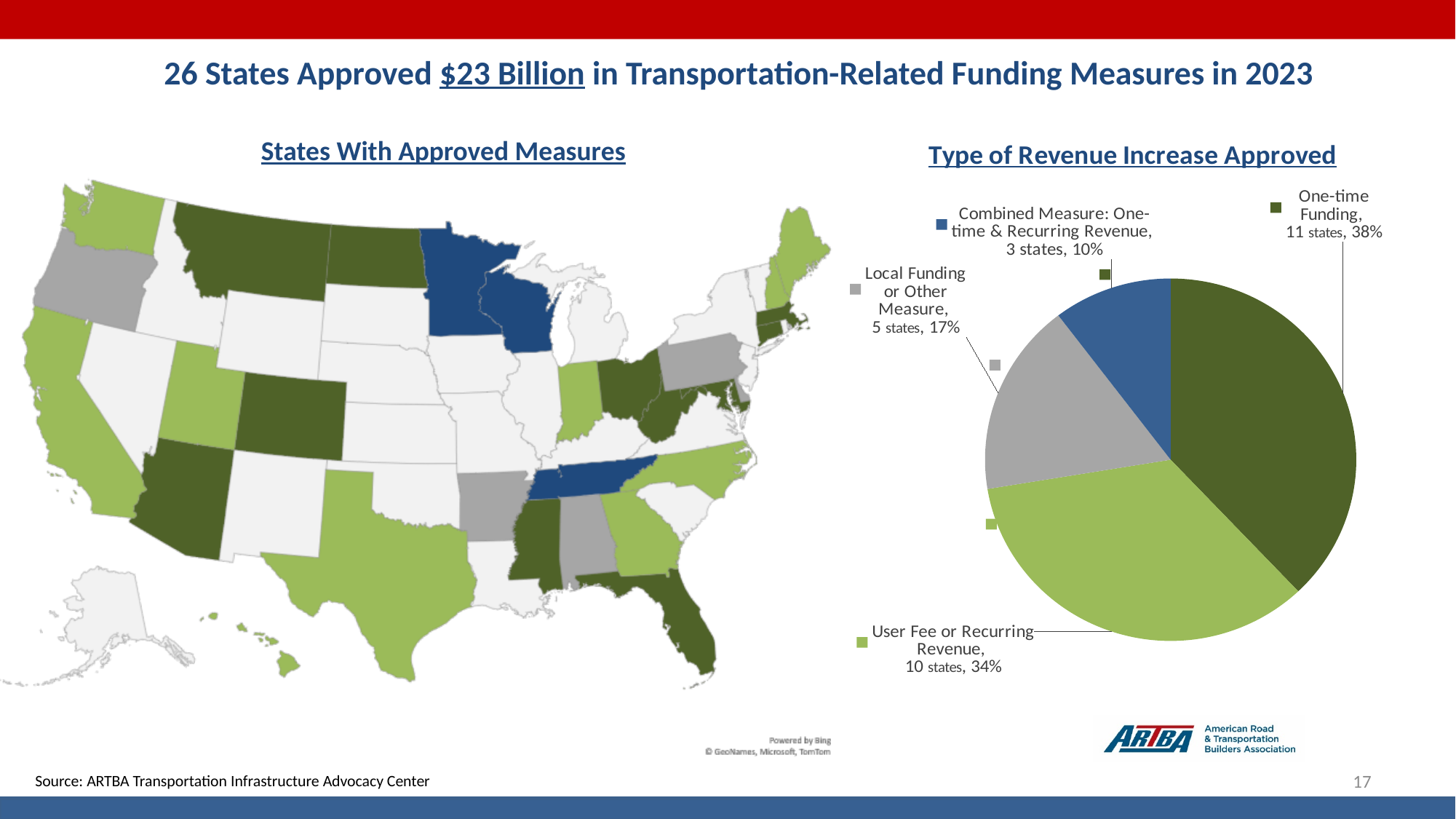
In the 'Type of Revenue Increase Approved' chart, what is the difference in percentage between One-time Funding and User Fee or Recurring Revenue? 4% In the 'Type of Revenue Increase Approved' chart, how many states approved One-time Funding? 11 states In the 'Type of Revenue Increase Approved' chart, how many states approved a Combined Measure: One-time & Recurring Revenue? 3 states In the 'Type of Revenue Increase Approved' chart, which category has the smallest share? Combined Measure: One-time & Recurring Revenue In the 'Type of Revenue Increase Approved' chart, which has a larger share: User Fee or Recurring Revenue or Local Funding or Other Measure? User Fee or Recurring Revenue What is the title of the chart on the left side of the slide? States With Approved Measures In the 'Type of Revenue Increase Approved' chart, what share of the pie is User Fee or Recurring Revenue? 34% In the 'Type of Revenue Increase Approved' chart, what kind of chart is shown? Pie chart In the 'Type of Revenue Increase Approved' chart, how many more states approved One-time Funding than Local Funding or Other Measure? 6 states In the 'Type of Revenue Increase Approved' chart, which category has the largest share? One-time Funding In the 'Type of Revenue Increase Approved' chart, how many categories (slices) are shown? 4 In the 'Type of Revenue Increase Approved' chart, what percentage is shown for Local Funding or Other Measure? 17%